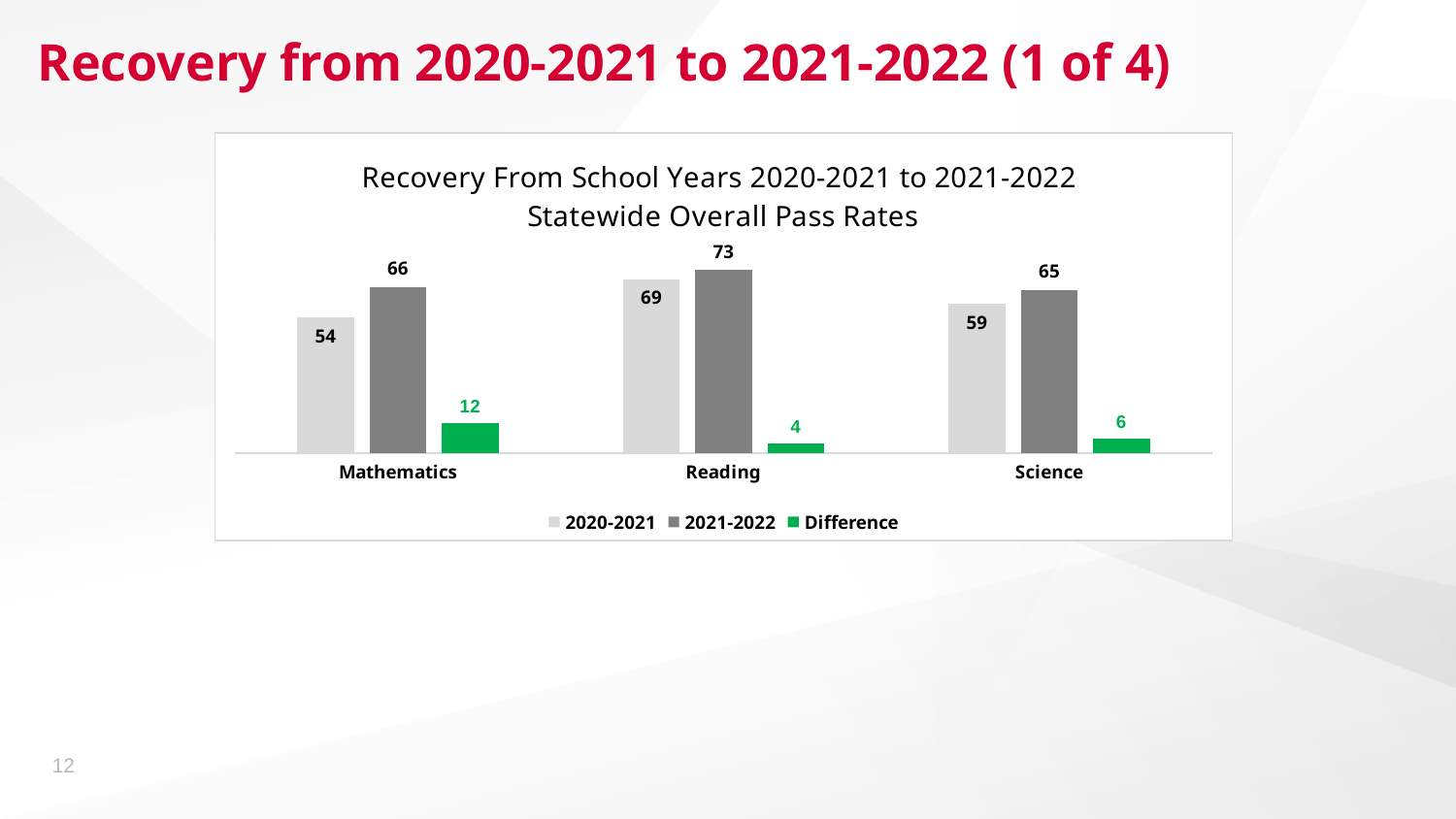
Which subject has the highest 2021-2022 pass rate? Reading What is the 2021-2022 pass rate for Reading? 73 What is the title of the chart? Recovery From School Years 2020-2021 to 2021-2022 Statewide Overall Pass Rates How many subjects are shown on the x axis? 3 What is the Difference value for Science? 6 How many series does the legend list? 3 Which subject has the largest Difference value? Mathematics Which subject has the lowest 2020-2021 pass rate? Mathematics Which is larger, the 2020-2021 pass rate for Reading or the 2021-2022 pass rate for Science? 2020-2021 pass rate for Reading What is the 2020-2021 pass rate for Mathematics? 54 What kind of chart is shown on the slide? Bar chart What is the difference between the 2021-2022 and 2020-2021 pass rates for Science? 6